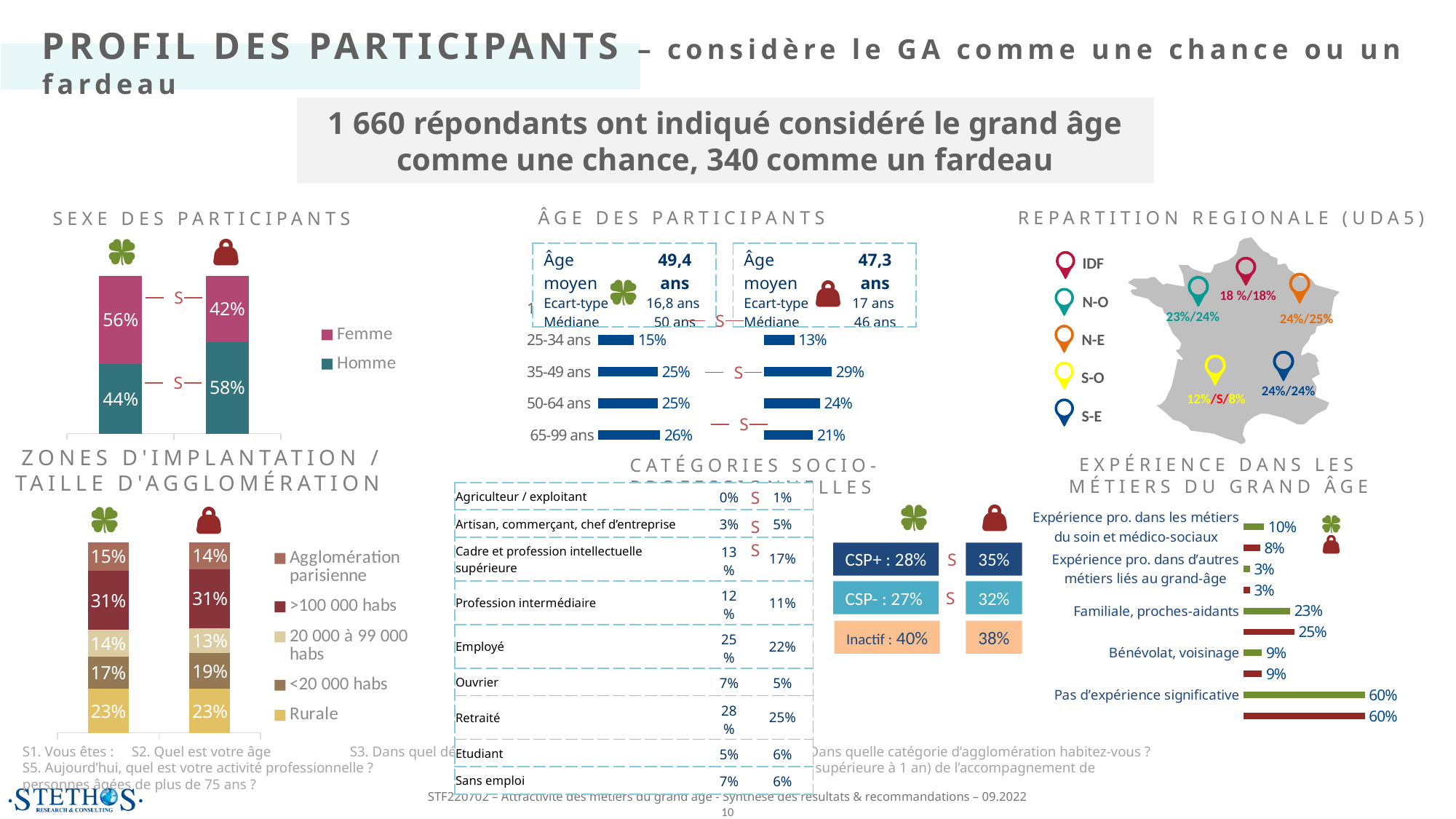
What type of chart is 'EXPÉRIENCE DANS LES MÉTIERS DU GRAND ÂGE'? Bar chart In the 'SEXE DES PARTICIPANTS' chart, what is the Homme share in the right bar (bag icon)? 58% In the 'ZONES D'IMPLANTATION / TAILLE D'AGGLOMÉRATION' chart, what is the Rurale share in the left bar? 23% In the 'EXPÉRIENCE DANS LES MÉTIERS DU GRAND ÂGE' chart, what is the value for 'Pas d'expérience significative' in the green series? 60% In the 'ZONES D'IMPLANTATION / TAILLE D'AGGLOMÉRATION' chart, how many categories does the legend list? 5 In the 'ÂGE DES PARTICIPANTS' chart, what is the difference between the left-hand and right-hand values for 65-99 ans? 5% In the 'ÂGE DES PARTICIPANTS' chart, what is the value for 35-49 ans in the right-hand series? 29% In the 'EXPÉRIENCE DANS LES MÉTIERS DU GRAND ÂGE' chart, what is the difference between the red and green values for 'Familiale, proches-aidants'? 2% In the 'SEXE DES PARTICIPANTS' chart, how many series does the legend list? 2 In the 'SEXE DES PARTICIPANTS' chart, what is the Femme share in the left bar (clover icon)? 56% In the 'ZONES D'IMPLANTATION / TAILLE D'AGGLOMÉRATION' chart, which category has the largest share in the right bar (bag icon)? >100 000 habs In the 'ÂGE DES PARTICIPANTS' chart, which is larger for 25-34 ans: the left-hand value or the right-hand value? Left-hand value (15%)